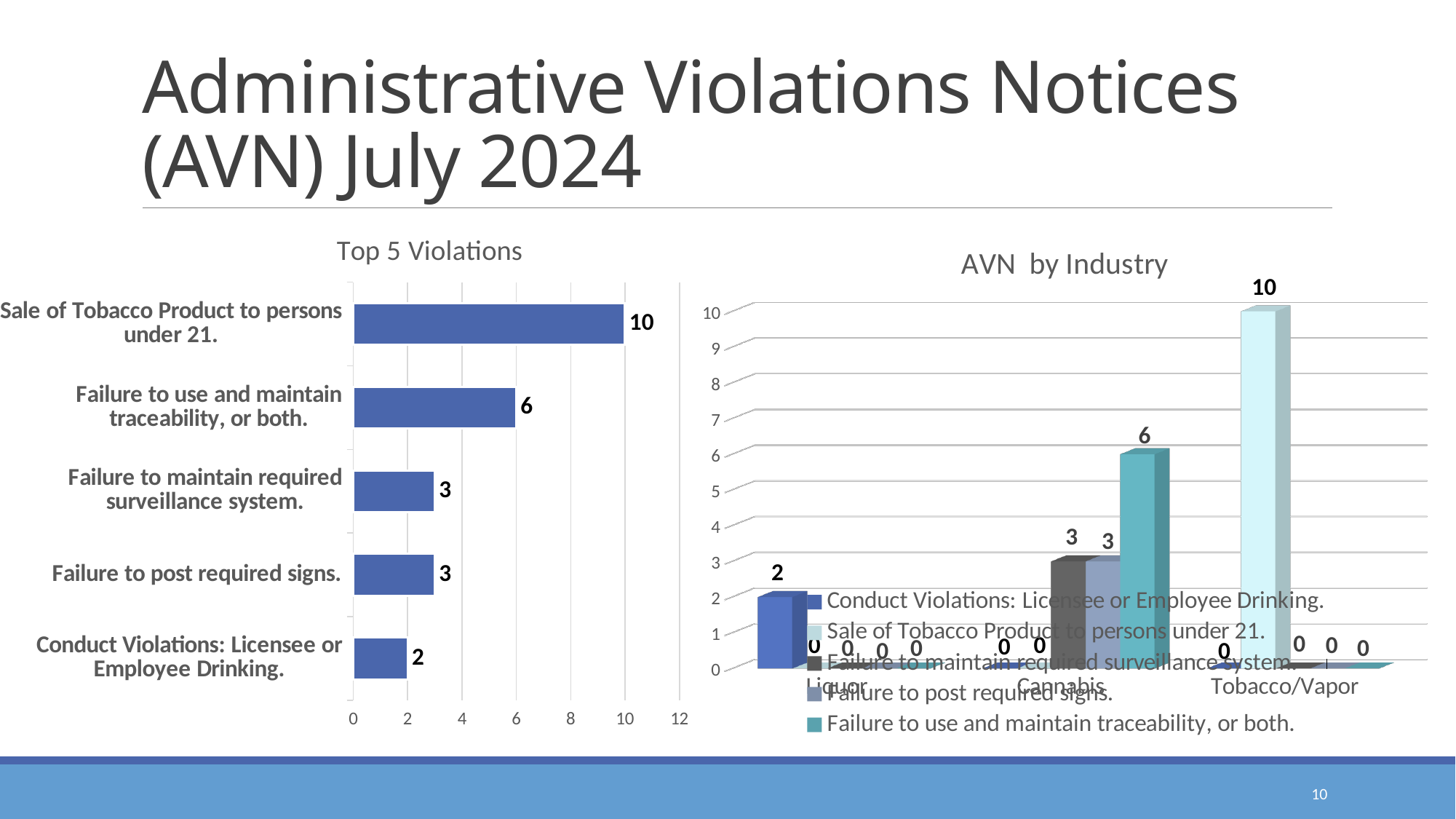
In the Top 5 Violations chart, what is the value for Failure to use and maintain traceability, or both.? 6 In the AVN by Industry chart, what is the value for Failure to use and maintain traceability, or both. for Cannabis? 6 In the Top 5 Violations chart, which category has the highest value? Sale of Tobacco Product to persons under 21. In the Top 5 Violations chart, which category has the lowest value? Conduct Violations: Licensee or Employee Drinking. In the Top 5 Violations chart, what is the difference between the values for Sale of Tobacco Product to persons under 21. and Failure to use and maintain traceability, or both.? 4 How many categories are shown in the Top 5 Violations chart? 5 In the Top 5 Violations chart, what is the value for Sale of Tobacco Product to persons under 21.? 10 What kind of chart is the Top 5 Violations chart? Bar chart In the AVN by Industry chart, is the value for Failure to use and maintain traceability, or both. for Cannabis larger or smaller than the value for Conduct Violations: Licensee or Employee Drinking. for Liquor? Larger In the AVN by Industry chart, how many series does the legend list? 5 In the AVN by Industry chart, what is the value for Conduct Violations: Licensee or Employee Drinking. for Liquor? 2 In the AVN by Industry chart, which industry has the highest value for Sale of Tobacco Product to persons under 21.? Tobacco/Vapor